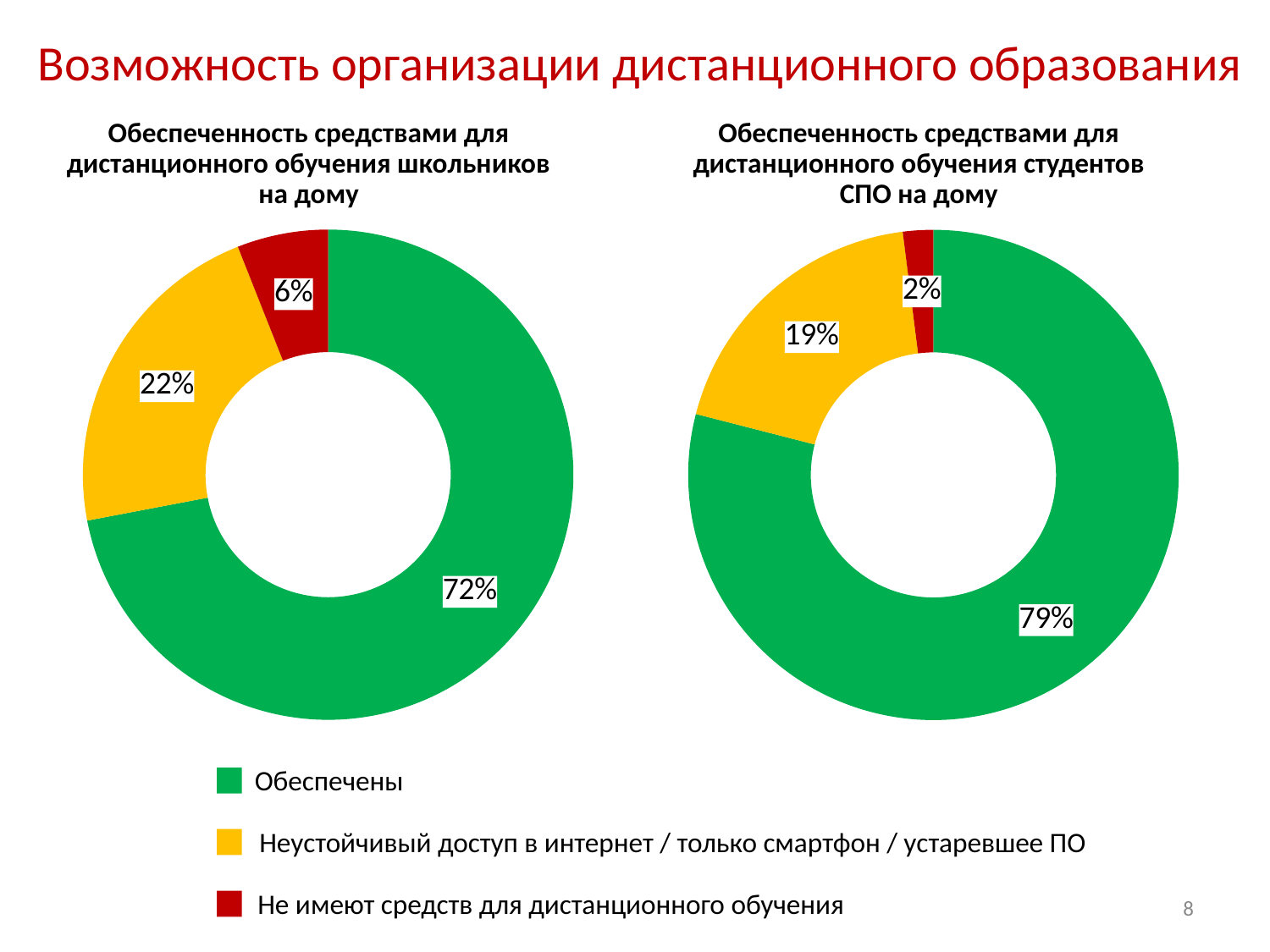
Which chart shows a larger share for 'Не имеют средств для дистанционного обучения': the left (школьников) or the right (студентов СПО)? Left (школьников) On the left chart (Обеспеченность средствами для дистанционного обучения школьников на дому), what share is labelled for the 'Обеспечены' slice? 72% On the right chart (студентов СПО), which category has the largest slice? Обеспечены On the right chart (студентов СПО), what share is labelled for 'Неустойчивый доступ в интернет / только смартфон / устаревшее ПО'? 19% On the right chart (Обеспеченность средствами для дистанционного обучения студентов СПО на дому), what share is labelled for the 'Обеспечены' slice? 79% On the left chart (школьников), what is the difference between the 'Неустойчивый доступ' slice and the 'Не имеют средств' slice? 16% Which colour represents 'Обеспечены' in the legend? Green What type of chart is used on the slide? Donut (pie) chart On the left chart (школьников), which category has the smallest slice? Не имеют средств для дистанционного обучения What is the difference between the 'Обеспечены' share on the right chart (студентов СПО) and on the left chart (школьников)? 7% On the left chart (школьников), what share is labelled for 'Не имеют средств для дистанционного обучения'? 6% How many slices does each donut chart on the slide have? 3